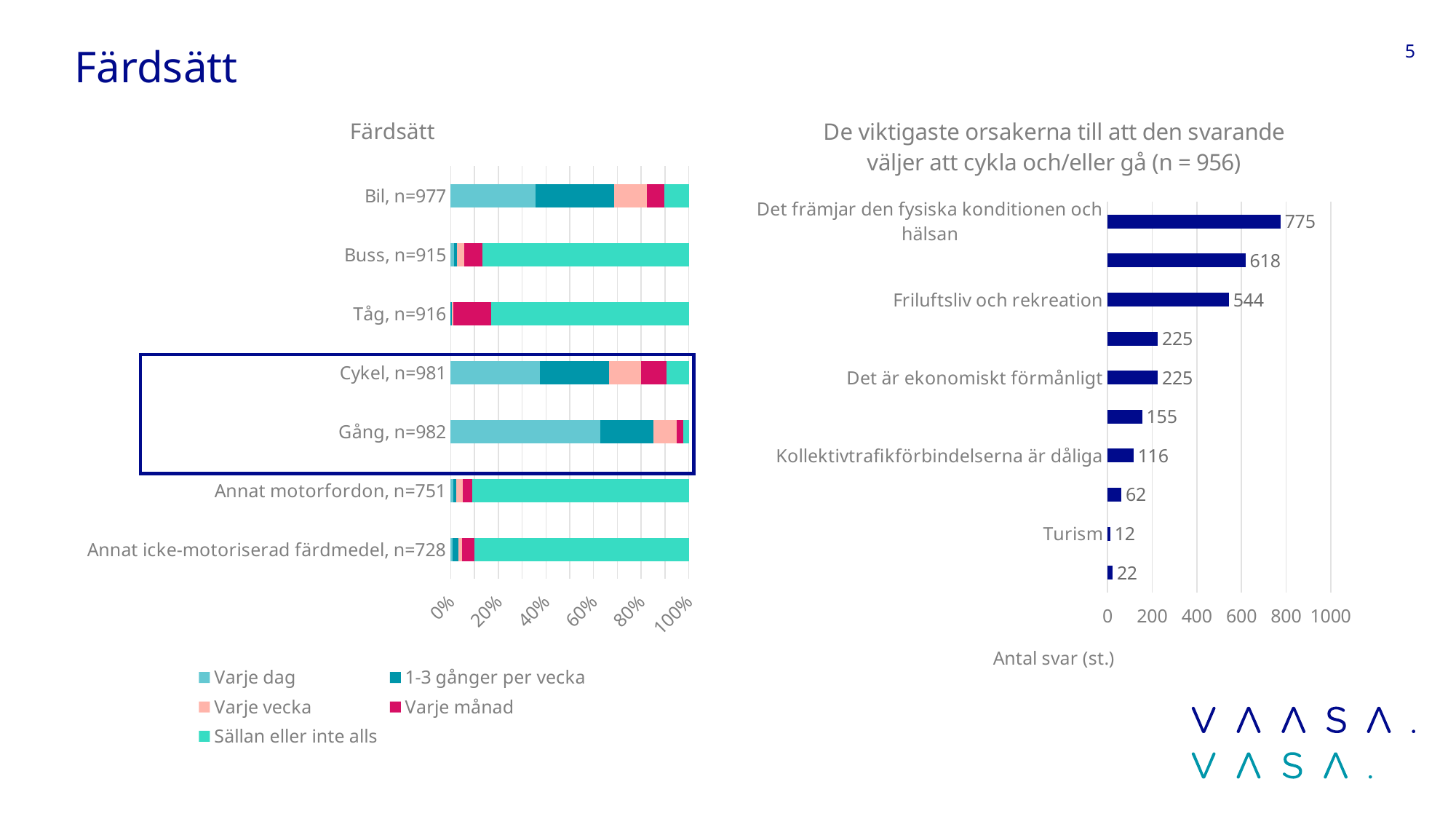
In the chart 'De viktigaste orsakerna till att den svarande väljer att cykla och/eller gå', what is the value for 'Det främjar den fysiska konditionen och hälsan'? 775 In the chart on the right, what is the difference between 'Det främjar den fysiska konditionen och hälsan' and 'Friluftsliv och rekreation'? 231 What kind of chart is the 'Färdsätt' chart on the left? stacked bar chart In the chart 'De viktigaste orsakerna till att den svarande väljer att cykla och/eller gå', what is the value for 'Kollektivtrafikförbindelserna är dåliga'? 116 In the chart 'De viktigaste orsakerna till att den svarande väljer att cykla och/eller gå', what is the value for 'Friluftsliv och rekreation'? 544 In the chart 'De viktigaste orsakerna till att den svarande väljer att cykla och/eller gå', what is the value for 'Turism'? 12 In the chart on the right, how many bars are plotted? 10 In the 'Färdsätt' chart on the left, how many travel modes (categories) are shown? 7 In the 'Färdsätt' chart on the left, how many series does the legend list? 5 In the chart on the right, which labelled reason has the highest number of responses? Det främjar den fysiska konditionen och hälsan In the 'Färdsätt' chart on the left, is the 'Sällan eller inte alls' share for 'Buss, n=915' greater or less than 80%? greater